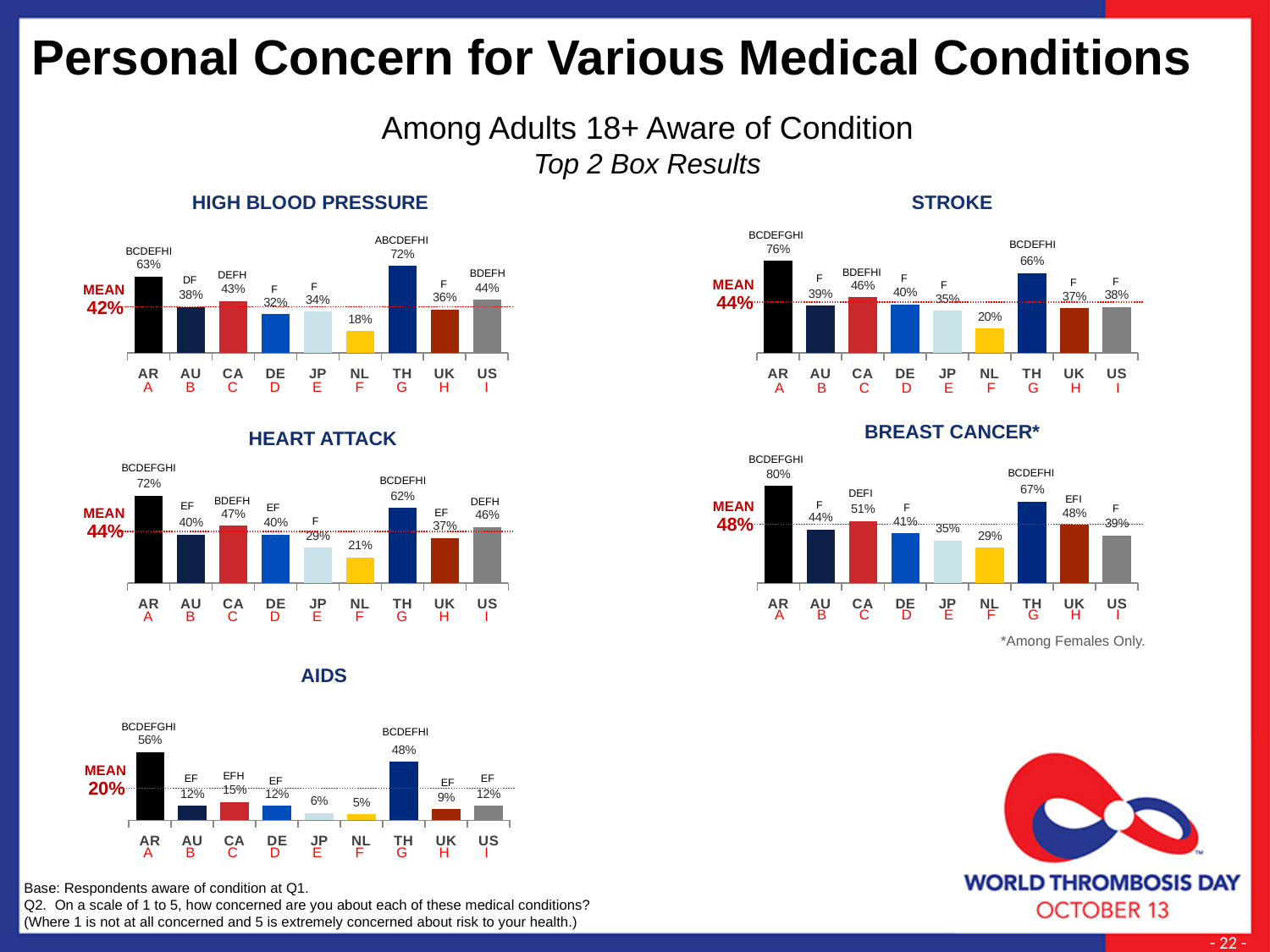
In the STROKE chart, what is the value for NL? 20% What is the MEAN value shown on the AIDS chart? 20% In the AIDS chart, which country has the highest value? AR How many countries are shown in the HEART ATTACK chart? 9 In the BREAST CANCER* chart, what is the value for AR? 80% In the HIGH BLOOD PRESSURE chart, what is the value for TH? 72% In the HIGH BLOOD PRESSURE chart, which country has the lowest value? NL In the BREAST CANCER* chart, what is the difference between the values for AR and NL? 51% In the HEART ATTACK chart, what is the difference between the values for TH and UK? 25% In the STROKE chart, which is larger, the value for CA or the value for DE? CA In the AIDS chart, what is the value for JP? 6% In the HEART ATTACK chart, what is the value for AR? 72%